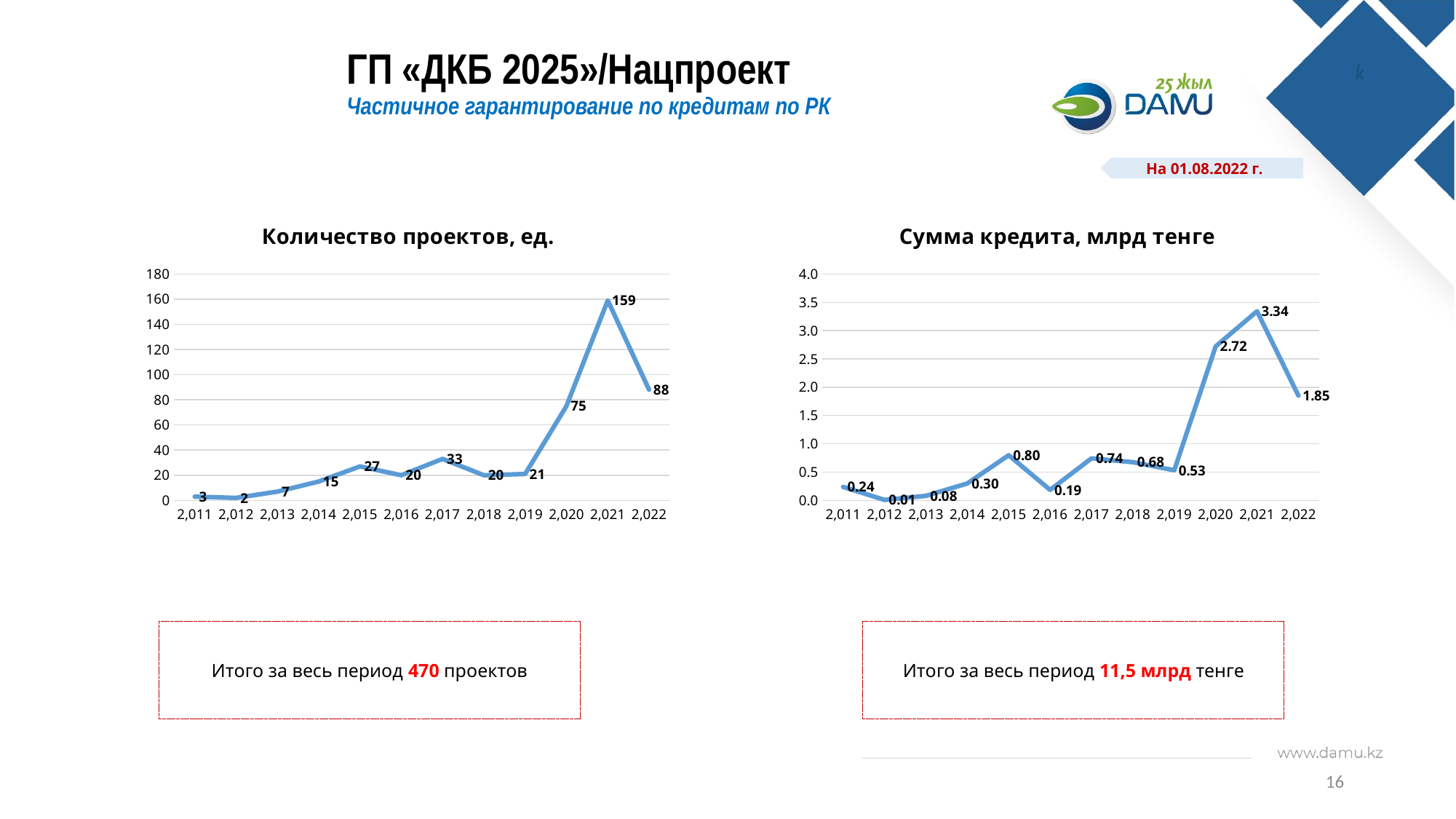
What is the title of the chart on the right side of the slide? Сумма кредита, млрд тенге In the chart titled 'Сумма кредита, млрд тенге', what is the value for 2,020? 2.72 How many years are plotted in the chart titled 'Количество проектов, ед.'? 12 In the chart titled 'Количество проектов, ед.', which is larger: the value for 2,017 or the value for 2,015? 2,017 What type of chart is the chart titled 'Сумма кредита, млрд тенге'? line chart In the chart titled 'Сумма кредита, млрд тенге', which year has the lowest value? 2,012 In the chart titled 'Сумма кредита, млрд тенге', is the value for 2,022 greater or less than 1.5? greater In the chart titled 'Количество проектов, ед.', what is the difference between the values for 2,021 and 2,022? 71 In the chart titled 'Количество проектов, ед.', what is the value for 2,021? 159 In the chart titled 'Количество проектов, ед.', which year has the highest value? 2,021 In the chart titled 'Количество проектов, ед.', do the values rise or fall from 2,019 to 2,021? rise In the chart titled 'Сумма кредита, млрд тенге', what is the difference between the values for 2,021 and 2,020? 0.62